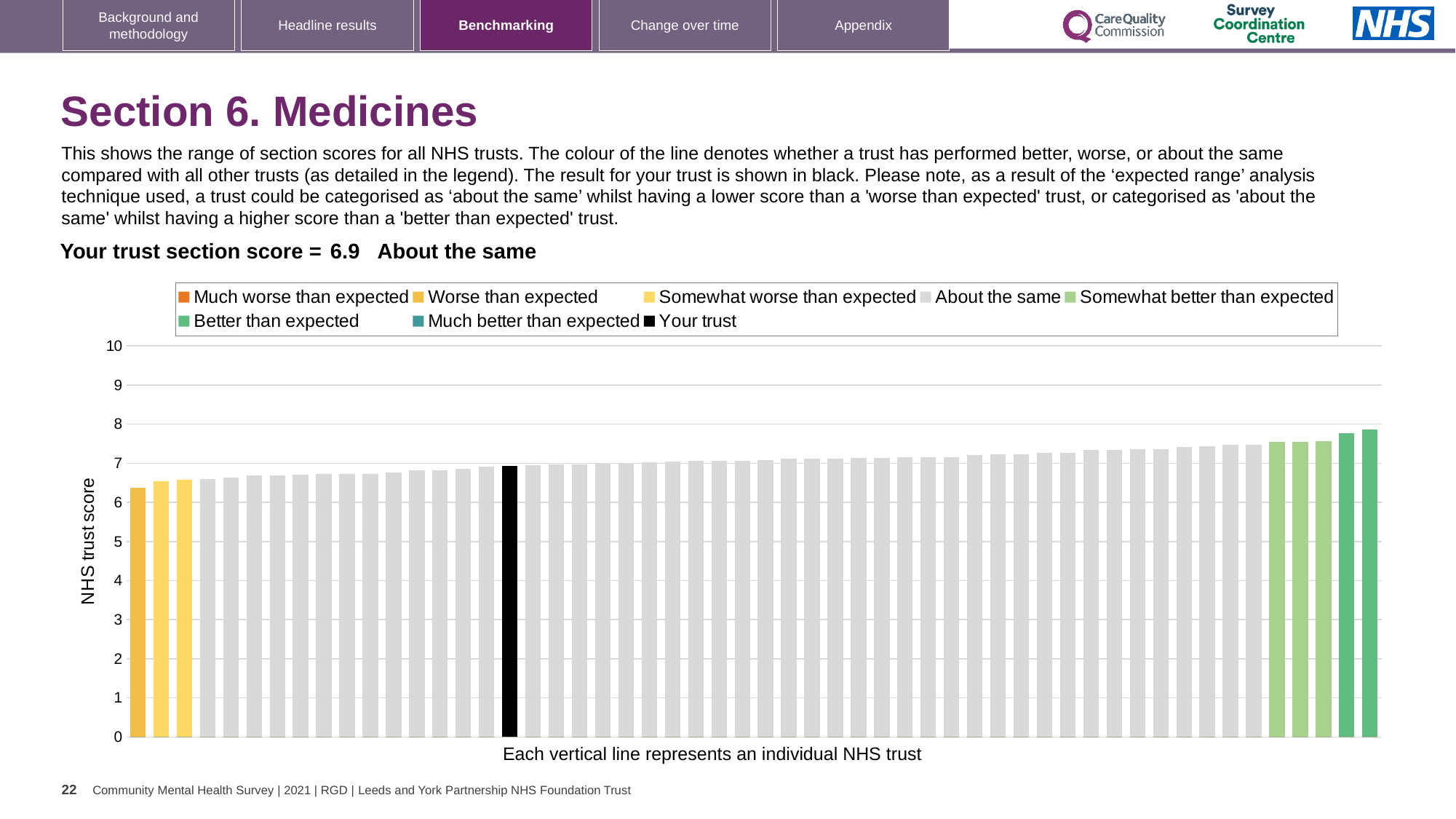
Is the value for your trust greater or less than 5? greater Is the value of the shortest bar (leftmost) greater or less than 7? less Do the bar values rise or fall from left to right along the x axis? Rise What is the label on the vertical axis of the chart? NHS trust score Which category is your trust's section score placed in? About the same Which is larger: the value for your trust or the value of the rightmost bar? The rightmost bar How many entries does the chart legend list? 8 Is the value of the tallest bar (rightmost) greater or less than 7? greater What kind of chart is shown on the slide? Bar chart What colour is the bar representing your trust? Black What is the section score for your trust shown on the slide? 6.9